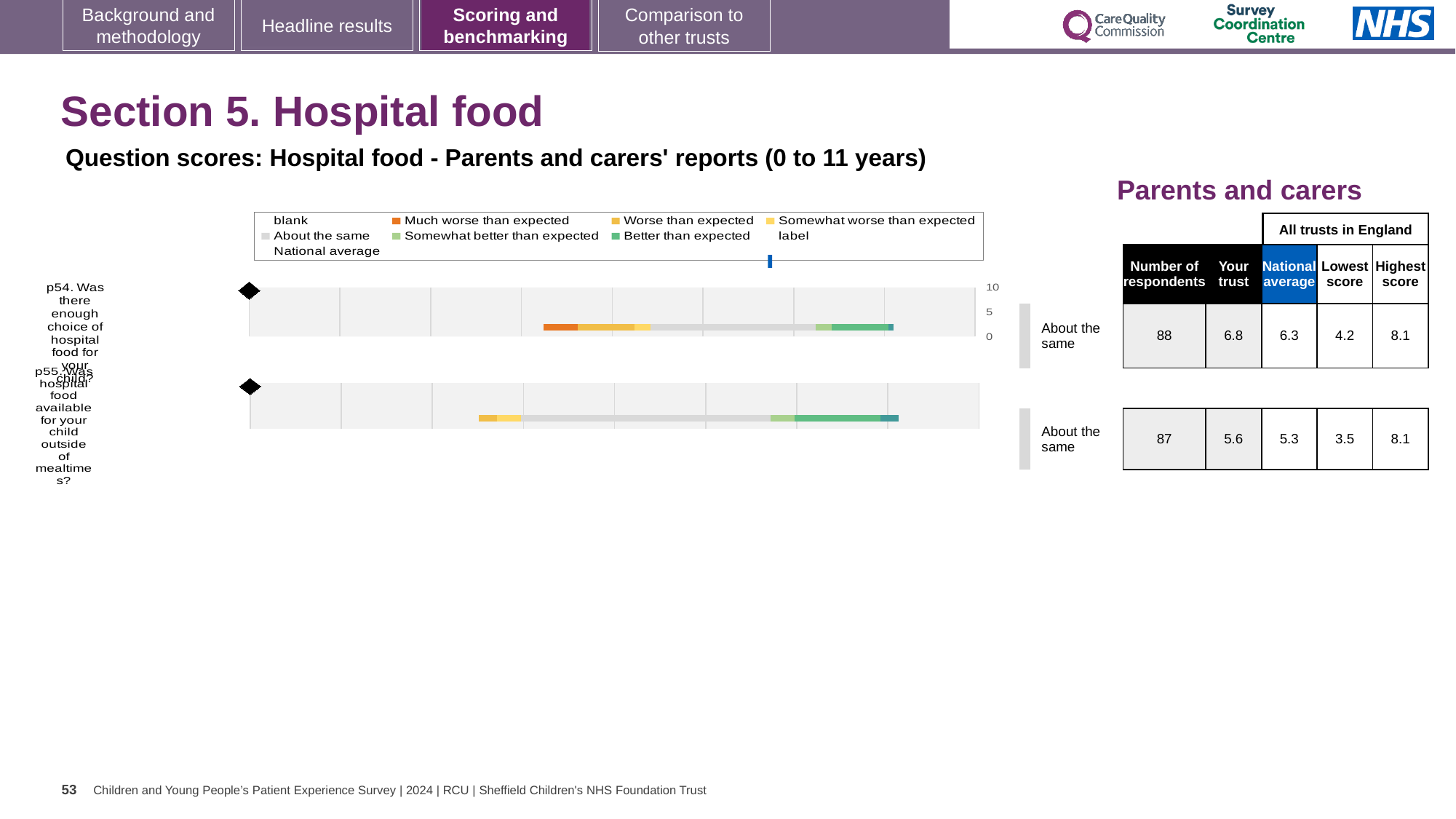
What kind of chart is used to show the question scores for hospital food? bar chart In the table beside the chart, which is larger for p54: the 'Your trust' score or the 'National average'? Your trust In the table beside the chart, how many respondents are listed for the second row (p55)? 87 In the legend of the hospital food chart, what colour represents 'Much worse than expected'? orange How many survey questions are plotted as bars in the hospital food chart? 2 In the table beside the chart, what is the difference between the highest score and the lowest score for p54? 3.9 What benchmark category is shown next to the bar for p55 (hospital food available outside of mealtimes)? About the same In the table beside the chart, what is the highest score for p55? 8.1 What benchmark category is shown next to the bar for p54 (enough choice of hospital food)? About the same How many entries does the legend of the hospital food chart list? 9 What is the heading above the hospital food chart? Question scores: Hospital food - Parents and carers' reports (0 to 11 years) In the table beside the chart, what is the 'Your trust' score for the first row (p54)? 6.8